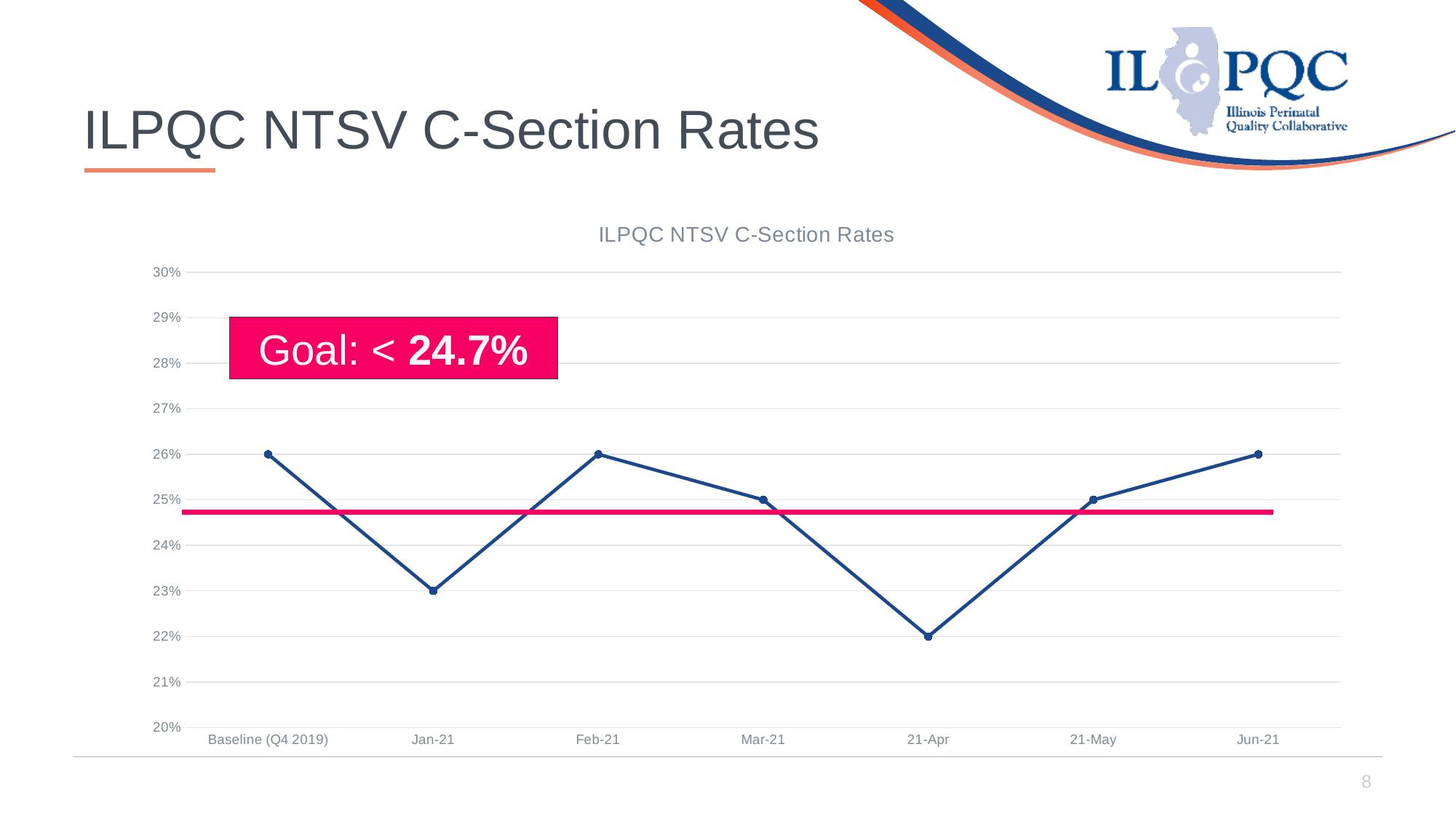
Is the value for 21-Apr greater or less than 24%? less Which month has the lowest NTSV C-section rate? 21-Apr What type of chart is shown on the slide? Line chart Which is larger, the rate for 21-May or the rate for Jun-21? Jun-21 How many data points are plotted on the line? 7 What is the title of the chart? ILPQC NTSV C-Section Rates What is the NTSV C-section rate for 21-Apr? 22% What is the NTSV C-section rate for Mar-21? 25% What goal value is shown in the box on the chart? < 24.7% What is the NTSV C-section rate for Baseline (Q4 2019)? 26% What is the difference between the rate for Feb-21 and the rate for Jan-21? 3% What is the NTSV C-section rate for Jan-21? 23%